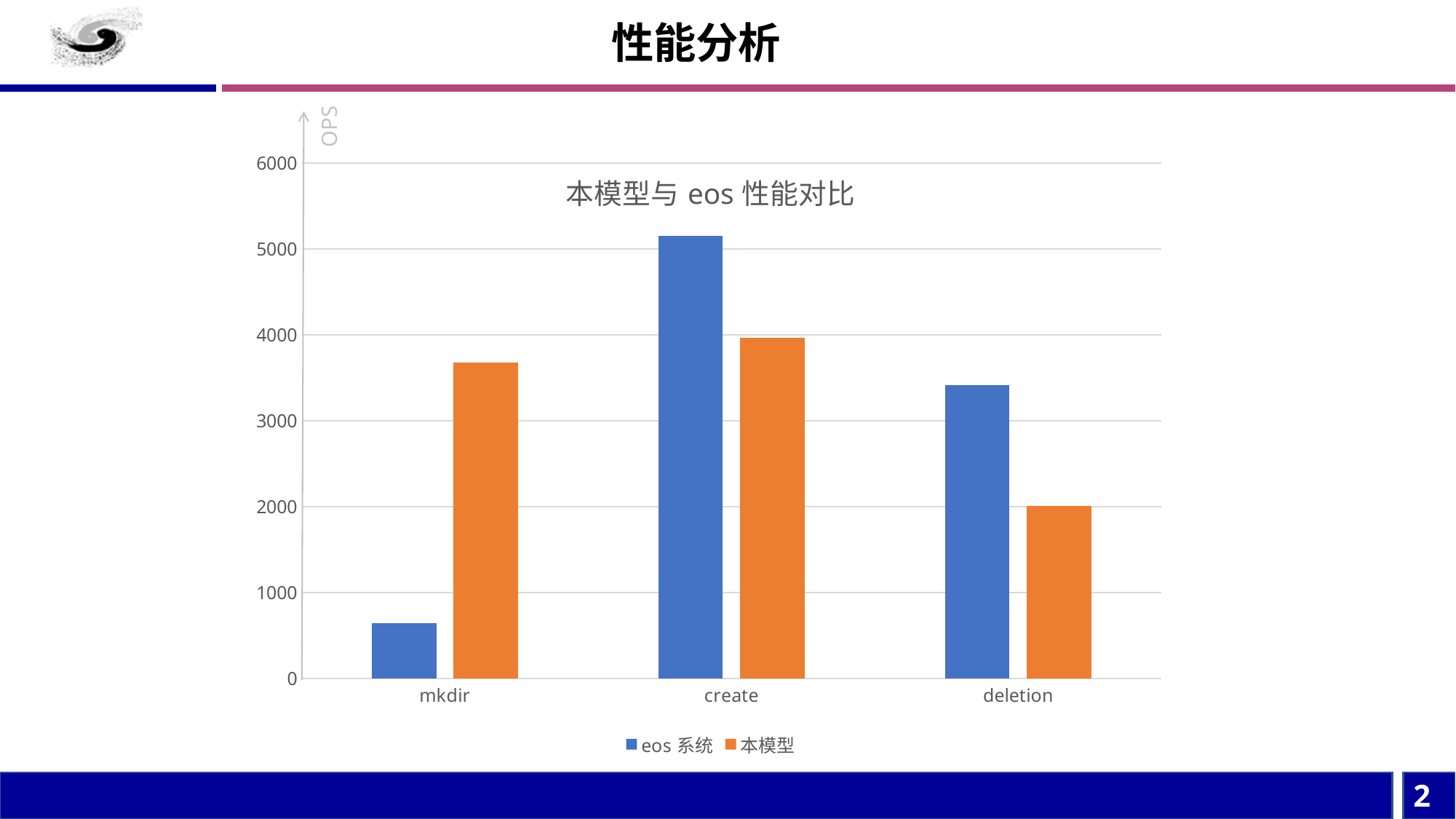
Is the value for eos 系统 at create greater or less than 5000? greater For mkdir, which series has the larger value, eos 系统 or 本模型? 本模型 For create, which series has the larger value, eos 系统 or 本模型? eos 系统 What kind of chart is shown on the slide? bar chart How many categories are shown on the x axis? 3 What label is shown on the vertical axis? OPS Which category has the lowest value for the eos 系统 series? mkdir Is the value for eos 系统 at mkdir greater or less than 1000? less How many series does the legend list? 2 Which category has the highest value for the eos 系统 series? create What is the title of the chart? 本模型与 eos 性能对比 Which category has the lowest value for the 本模型 series? deletion